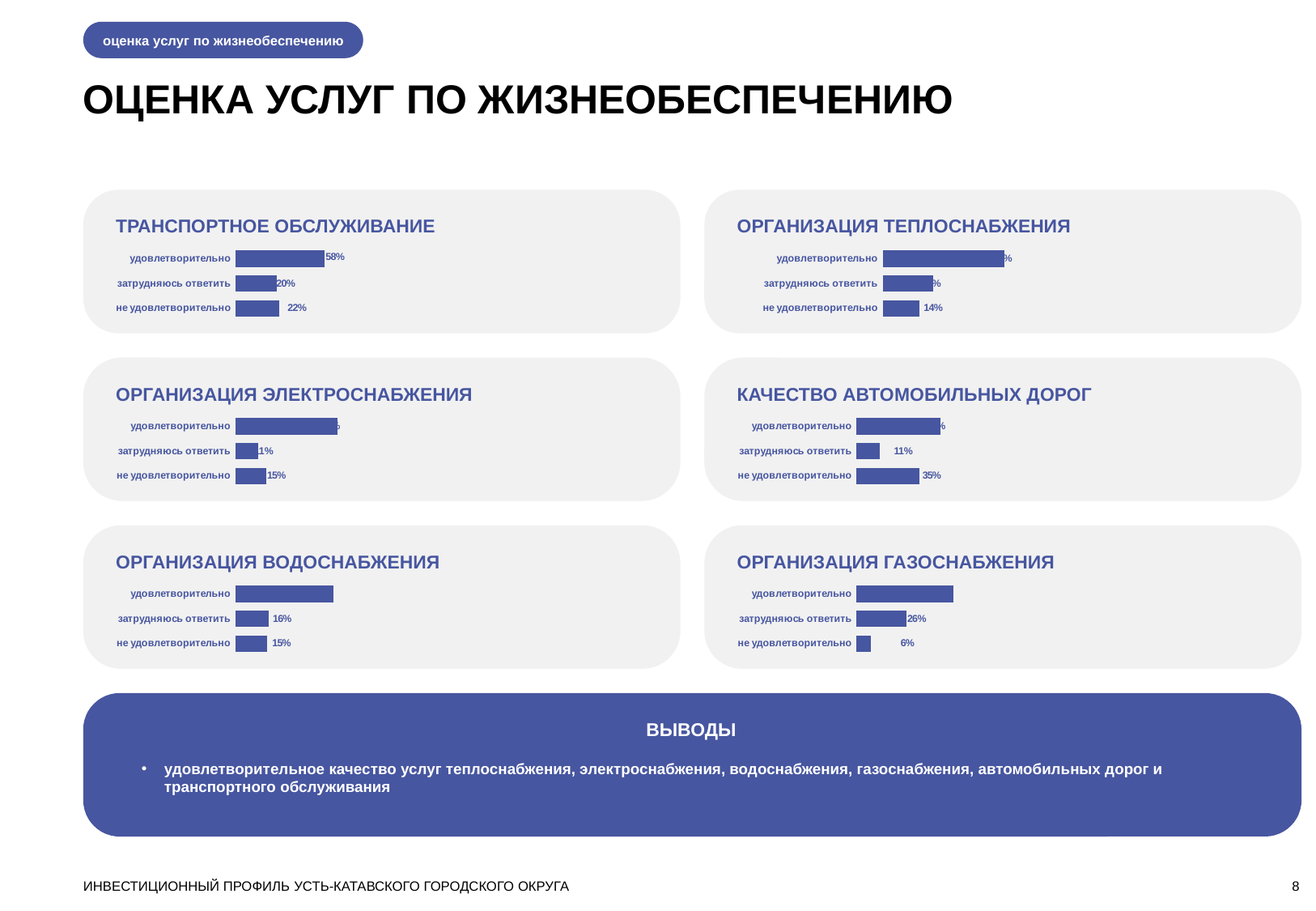
How many categories does the 'ОРГАНИЗАЦИЯ ВОДОСНАБЖЕНИЯ' chart show? 3 In the 'ОРГАНИЗАЦИЯ ТЕПЛОСНАБЖЕНИЯ' chart, what is the value for 'не удовлетворительно'? 14% In the 'КАЧЕСТВО АВТОМОБИЛЬНЫХ ДОРОГ' chart, which is larger: 'не удовлетворительно' or 'затрудняюсь ответить'? не удовлетворительно In the 'КАЧЕСТВО АВТОМОБИЛЬНЫХ ДОРОГ' chart, what is the value for 'не удовлетворительно'? 35% In the 'ТРАНСПОРТНОЕ ОБСЛУЖИВАНИЕ' chart, what is the value for 'не удовлетворительно'? 22% In the 'ОРГАНИЗАЦИЯ ЭЛЕКТРОСНАБЖЕНИЯ' chart, what is the value for 'не удовлетворительно'? 15% In the 'ОРГАНИЗАЦИЯ ГАЗОСНАБЖЕНИЯ' chart, what is the value for 'затрудняюсь ответить'? 26% In the 'ОРГАНИЗАЦИЯ ВОДОСНАБЖЕНИЯ' chart, which category has the highest value? удовлетворительно In the 'ОРГАНИЗАЦИЯ ГАЗОСНАБЖЕНИЯ' chart, which category has the lowest value? не удовлетворительно In the 'ТРАНСПОРТНОЕ ОБСЛУЖИВАНИЕ' chart, what is the value for 'удовлетворительно'? 58% In the 'КАЧЕСТВО АВТОМОБИЛЬНЫХ ДОРОГ' chart, what is the value for 'затрудняюсь ответить'? 11% In the 'ТРАНСПОРТНОЕ ОБСЛУЖИВАНИЕ' chart, what is the difference between 'удовлетворительно' and 'не удовлетворительно'? 36%